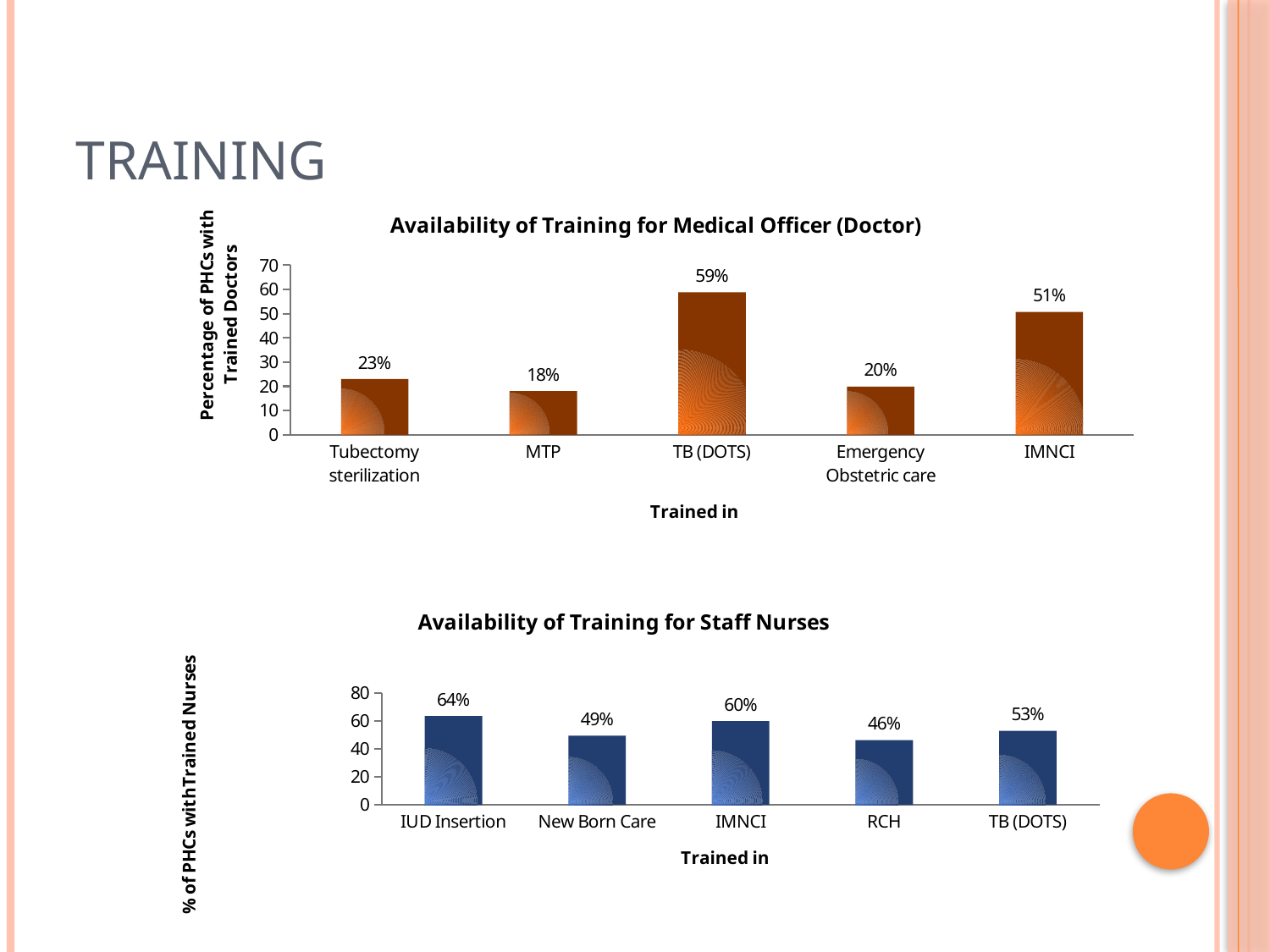
In the 'Availability of Training for Medical Officer (Doctor)' chart, how many categories are shown on the x axis? 5 In the 'Availability of Training for Staff Nurses' chart, which category has the highest value? IUD Insertion In the 'Availability of Training for Medical Officer (Doctor)' chart, what is the value for TB (DOTS)? 59% In the 'Availability of Training for Staff Nurses' chart, what is the value for RCH? 46% In the 'Availability of Training for Medical Officer (Doctor)' chart, which category has the lowest value? MTP In the 'Availability of Training for Medical Officer (Doctor)' chart, which category has the highest value? TB (DOTS) In the 'Availability of Training for Staff Nurses' chart, which category has the lowest value? RCH What kind of chart is the 'Availability of Training for Staff Nurses' chart? Bar chart In the 'Availability of Training for Staff Nurses' chart, what is the difference between the values for IUD Insertion and IMNCI? 4% What is the x-axis title of the 'Availability of Training for Medical Officer (Doctor)' chart? Trained in In the 'Availability of Training for Staff Nurses' chart, which is larger, the value for New Born Care or the value for TB (DOTS)? TB (DOTS) In the 'Availability of Training for Medical Officer (Doctor)' chart, what is the difference between the values for IMNCI and Tubectomy sterilization? 28%